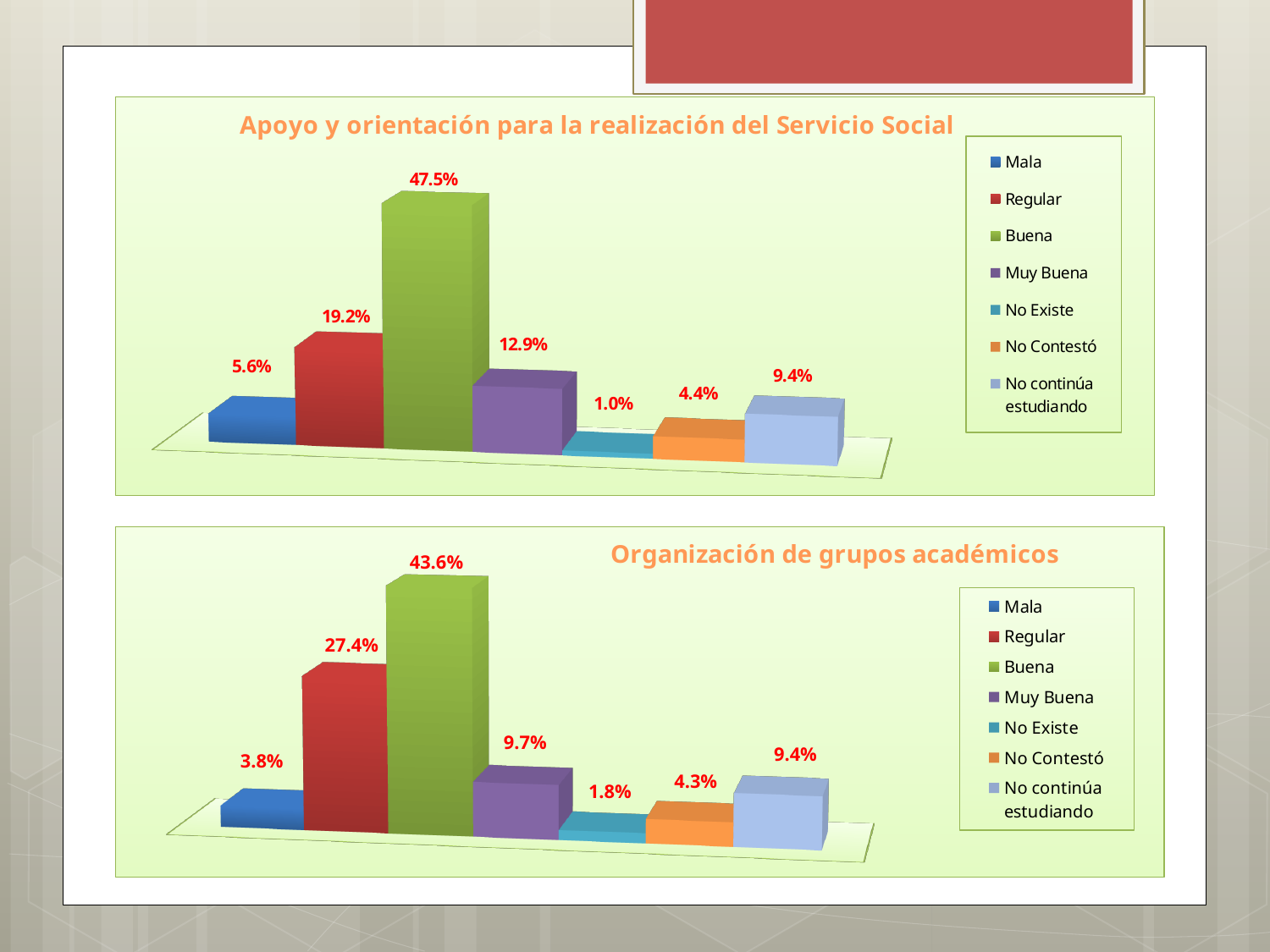
How many entries does the legend of the chart titled 'Organización de grupos académicos' list? 7 What kind of chart is the top chart on the slide? Bar chart In the chart titled 'Organización de grupos académicos', what is the value for Regular? 27.4% In the chart titled 'Apoyo y orientación para la realización del Servicio Social', how many bars are plotted? 7 In the chart titled 'Apoyo y orientación para la realización del Servicio Social', what is the value for Buena? 47.5% In the chart titled 'Organización de grupos académicos', what is the difference between Buena and Regular? 16.2% In the chart titled 'Apoyo y orientación para la realización del Servicio Social', which category has the lowest value? No Existe In the chart titled 'Organización de grupos académicos', which category has the highest value? Buena In the chart titled 'Organización de grupos académicos', what is the value for Muy Buena? 9.7% In the chart titled 'Apoyo y orientación para la realización del Servicio Social', what is the difference between Buena and Regular? 28.3% In the chart titled 'Organización de grupos académicos', which is larger, Mala or No Contestó? No Contestó In the chart titled 'Apoyo y orientación para la realización del Servicio Social', what is the value for Regular? 19.2%